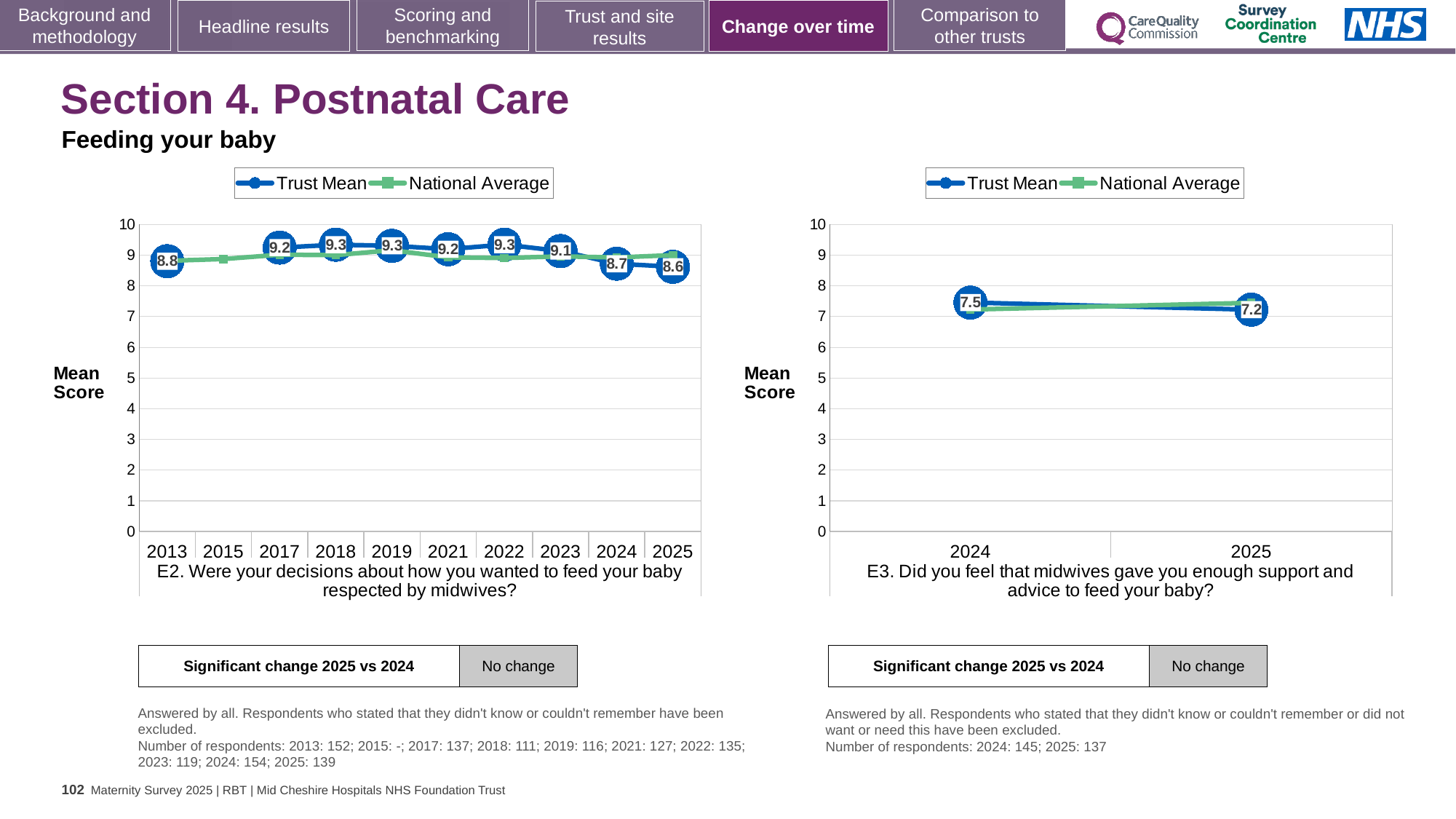
In the E2 chart on the left, what is the Trust Mean for 2025? 8.6 In the E3 chart on the right, what is the difference between the Trust Mean for 2024 and 2025? 0.3 In the E3 chart on the right, does the Trust Mean rise or fall from 2024 to 2025? fall In the E2 chart on the left, what is the Trust Mean for 2024? 8.7 In the E2 chart on the left, what is the Trust Mean for 2013? 8.8 In the E3 chart on the right, what is the Trust Mean for 2025? 7.2 What type of chart is the E2 chart on the left? line chart How many series does the legend of the E3 chart on the right list? 2 In the E2 chart on the left, how many years are shown on the x axis? 10 In the E2 chart on the left, is the Trust Mean for 2023 higher or lower than for 2024? higher In the E2 chart on the left, which year has the lowest Trust Mean? 2025 In the E3 chart on the right, what is the Trust Mean for 2024? 7.5